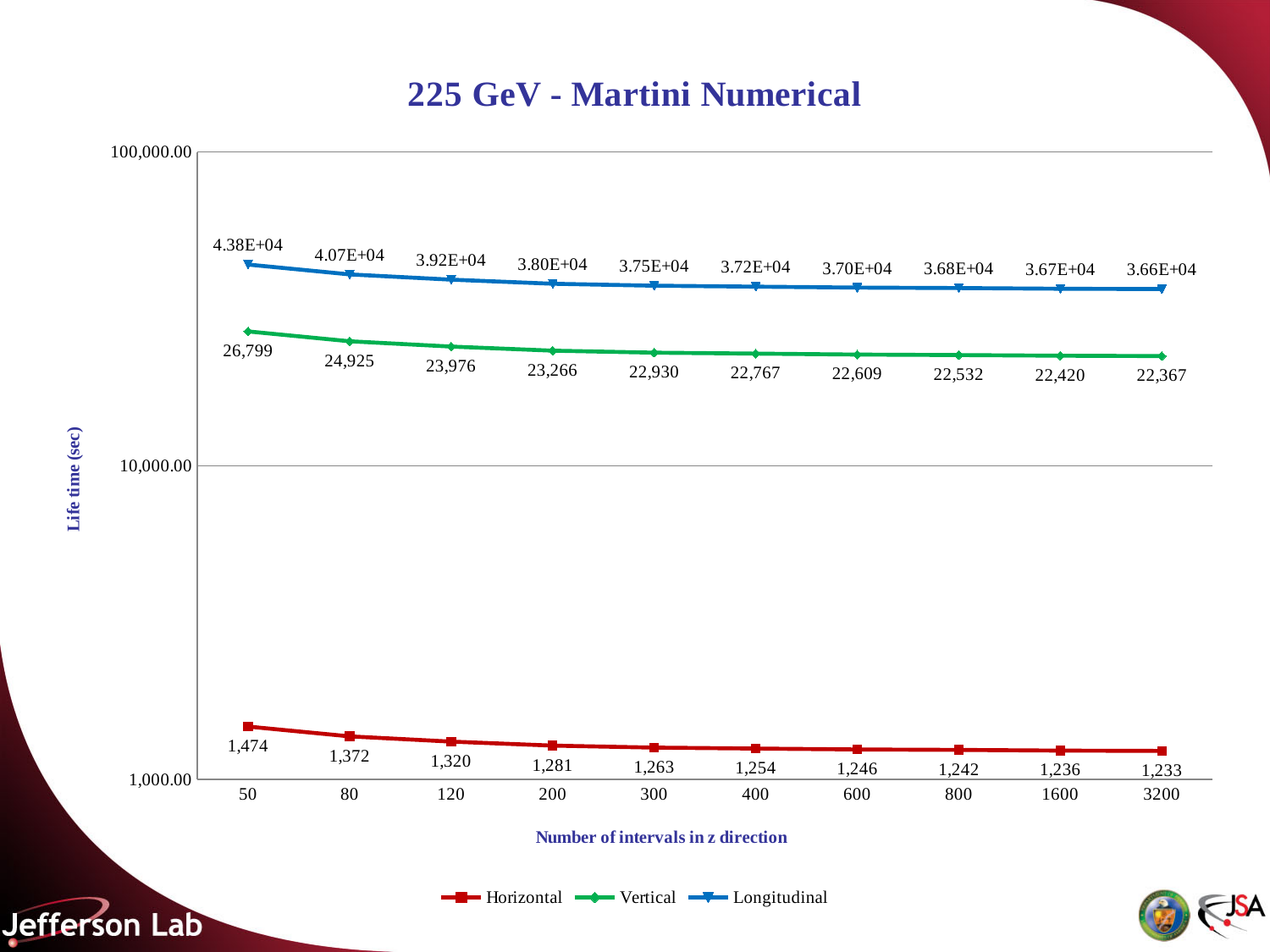
How many series does the legend list? 3 What is the Longitudinal life time at 200 intervals in z direction? 3.80E+04 What is the difference between the Vertical life time at 50 intervals and at 80 intervals? 1,874 How many x-axis categories (numbers of intervals) are plotted? 10 Is the Longitudinal life time at 3200 intervals greater or less than 10,000.00? greater What is the Horizontal life time at 50 intervals in z direction? 1,474 What is the Vertical life time at 3200 intervals in z direction? 22,367 At which number of intervals is the Vertical life time lowest? 3200 What is the Vertical life time at 400 intervals in z direction? 22,767 Which series has the larger life time at 120 intervals, Horizontal or Vertical? Vertical Does the Horizontal life time rise or fall as the number of intervals increases? fall At which number of intervals is the Horizontal life time highest? 50